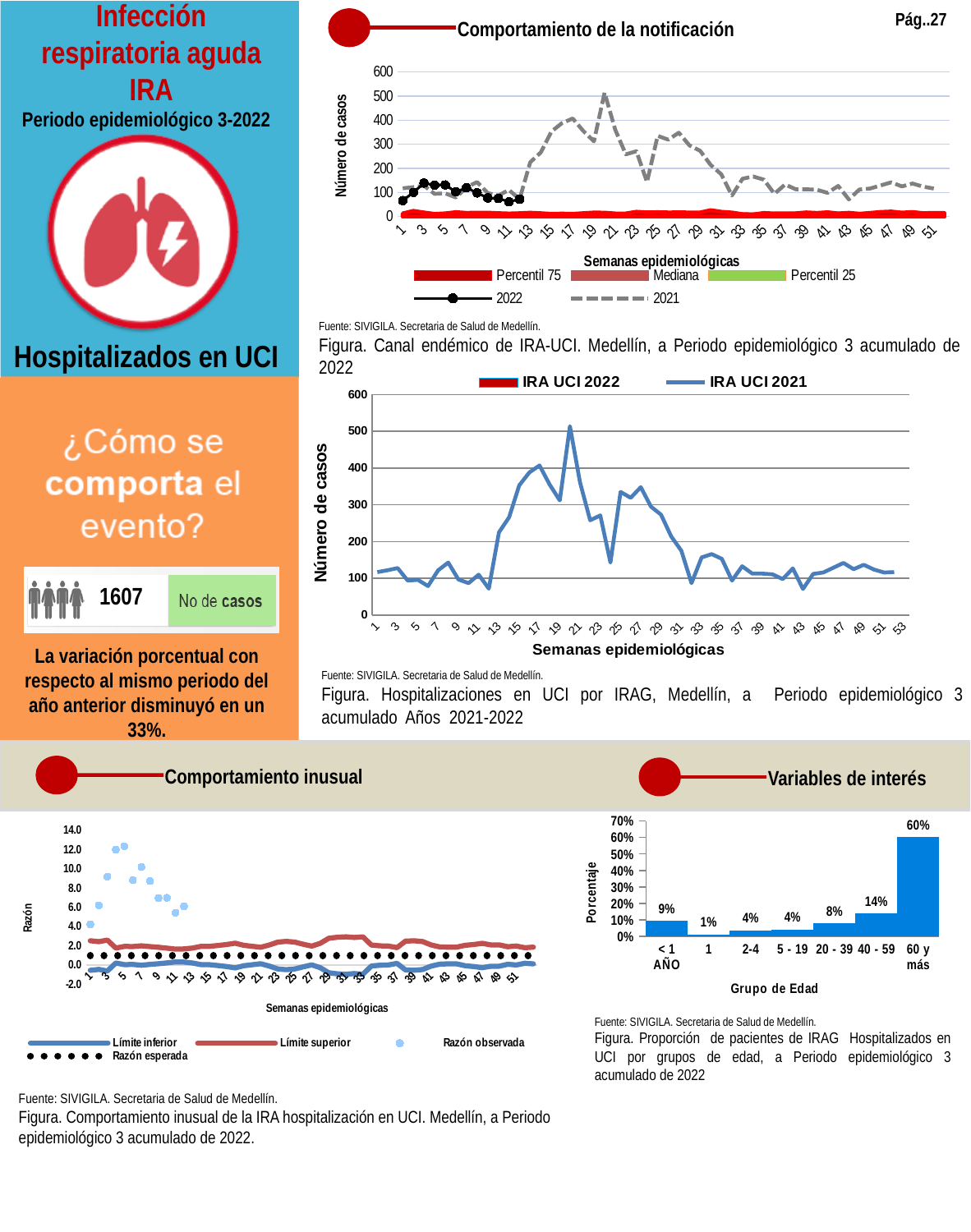
How many series does the legend list in the 'Hospitalizaciones en UCI por IRAG' chart (middle right)? 2 How many series does the legend list in the 'Canal endémico de IRA-UCI' chart (top right)? 5 In the bar chart by age group (bottom right), what is the difference between the '60 y más' group and the '40 - 59' group? 46% How many age groups are shown in the bar chart at the bottom right? 7 In the bar chart by age group (bottom right), which is larger: the value for '20 - 39' or the value for '2-4'? 20 - 39 What kind of chart is the 'Variables de interés' chart at the bottom right? Bar chart In the bar chart by age group (bottom right), which age group has the highest proportion? 60 y más In the bar chart of IRAG patients hospitalized in UCI by age group (bottom right), what is the value for the '60 y más' group? 60% In the bar chart by age group (bottom right), which age group has the lowest proportion? 1 In the bar chart by age group (bottom right), what is the value for the '40 - 59' group? 14% In the 'Hospitalizaciones en UCI por IRAG' chart (middle right), is the value of IRA UCI 2021 at week 19 greater or less than 400? less In the bar chart by age group (bottom right), what is the value for the '< 1 AÑO' group? 9%